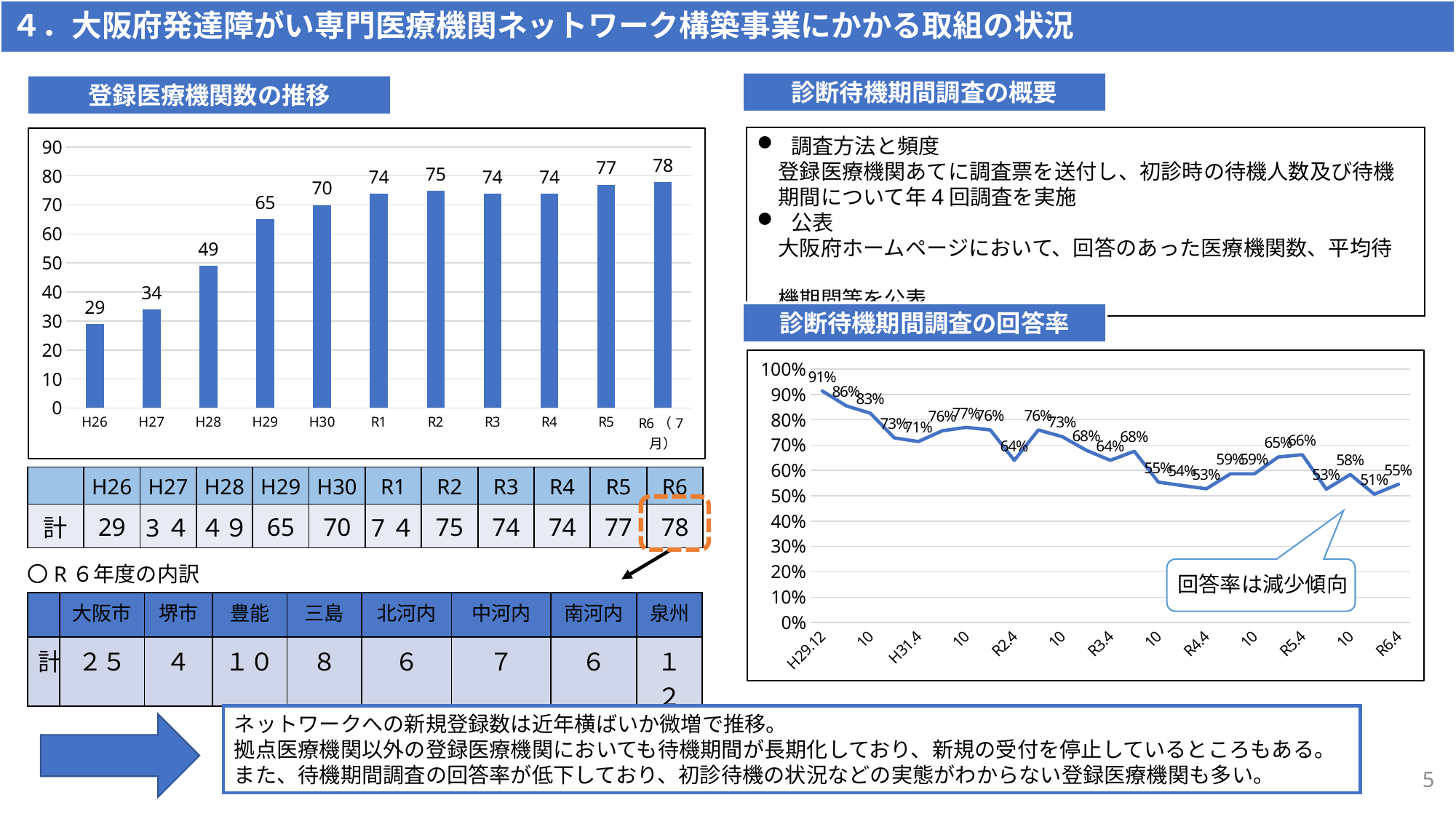
On the bar chart titled 登録医療機関数の推移, what is the value for H28? 49 On the bar chart titled 登録医療機関数の推移, what is the value for R6（7月）? 78 On the line chart titled 診断待機期間調査の回答率, do the values generally rise or fall from left to right? fall On the bar chart titled 登録医療機関数の推移, how many bars are plotted? 11 On the line chart titled 診断待機期間調査の回答率, what is the lowest value shown? 51% On the bar chart titled 登録医療機関数の推移, what is the difference between the values for H29 and H28? 16 On the bar chart titled 登録医療機関数の推移, which category has the highest value? R6（7月） What kind of chart is the chart titled 登録医療機関数の推移? bar chart On the line chart titled 診断待機期間調査の回答率, what is the value at H29.12? 91% On the line chart titled 診断待機期間調査の回答率, what is the value at R6.4? 55% On the bar chart titled 登録医療機関数の推移, which is larger, the value for H30 or the value for R2? R2 On the bar chart titled 登録医療機関数の推移, which category has the lowest value? H26